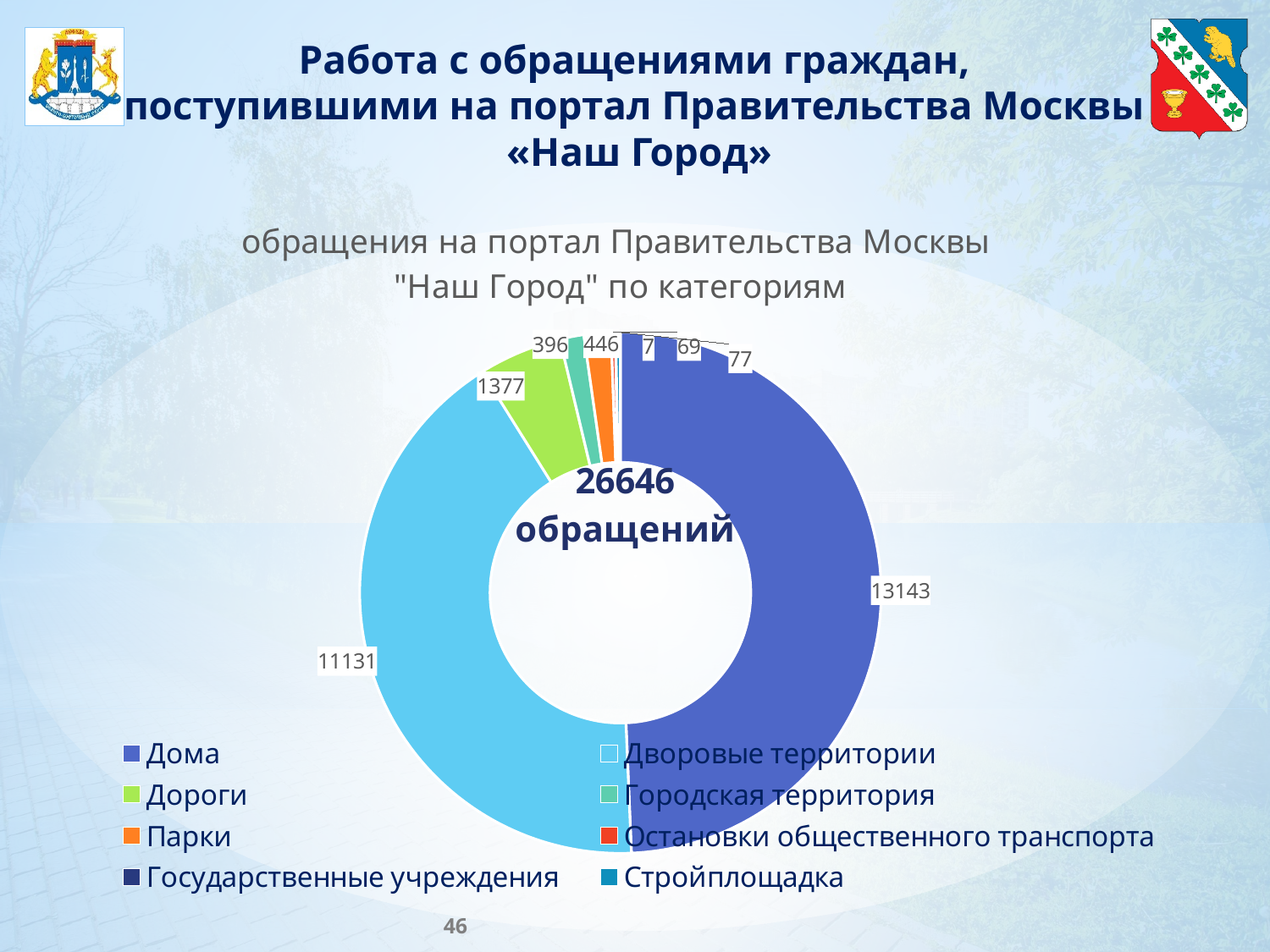
What is the difference between the values for Дома and Дворовые территории? 2012 What kind of chart is shown on the slide? Doughnut (pie) chart What is the value for Дороги? 1377 What total number of appeals is shown in the centre of the chart? 26646 обращений What is the smallest data label printed on the chart? 7 What is the value for Дворовые территории? 11131 Which category has the largest share of the chart? Дома What is the title of the chart? обращения на портал Правительства Москвы "Наш Город" по категориям What is the value for Дома? 13143 How many categories does the legend list? 8 What is the value for Парки? 446 Which is larger, the value for Дороги or the value for Парки? Дороги